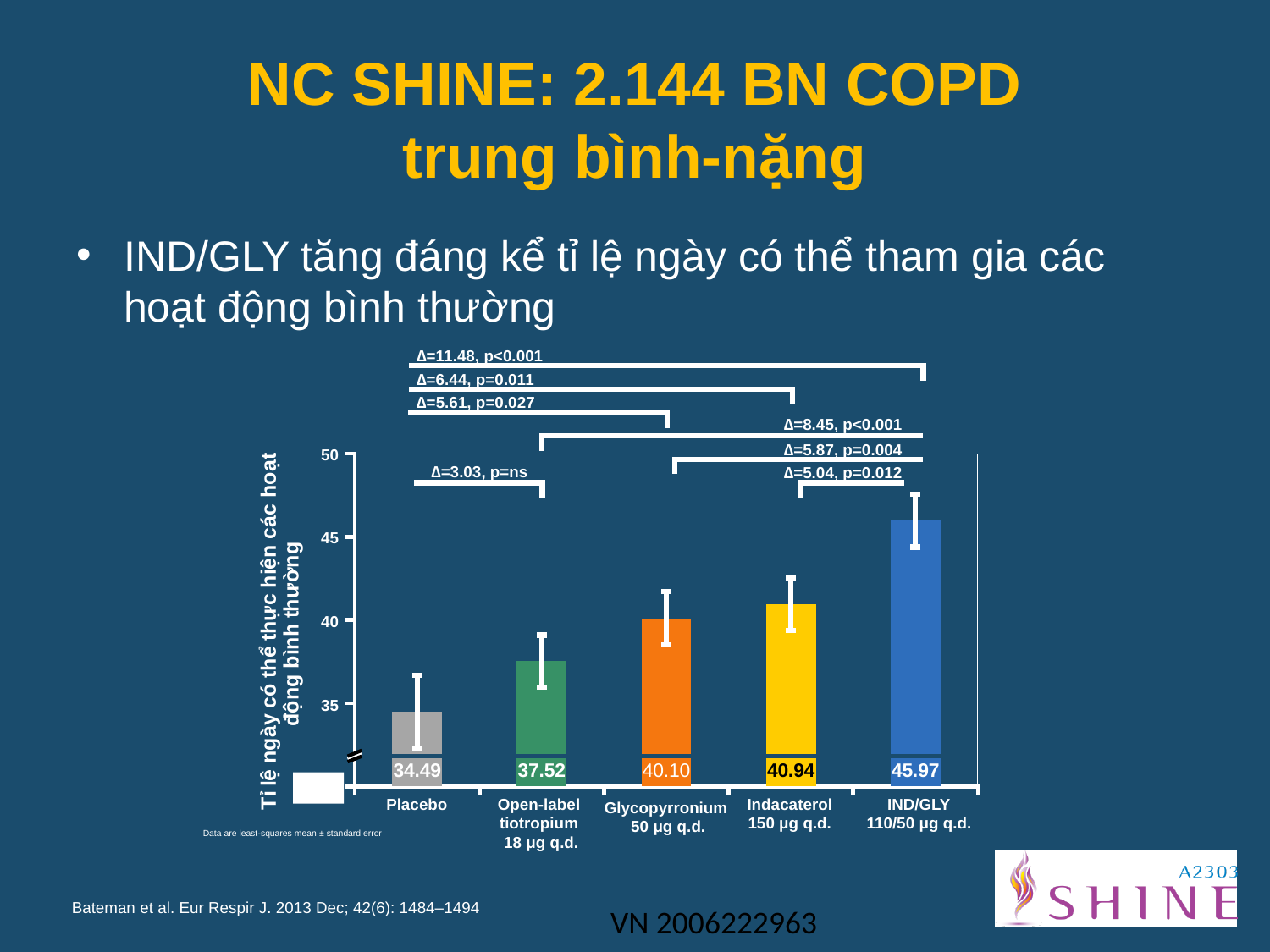
Which category has the highest value? IND/GLY 110/50 µg q.d. What is the value for Open-label tiotropium 18 µg q.d.? 37.52 Which category has the lowest value? Placebo What is the difference between the values for IND/GLY 110/50 µg q.d. and Placebo? 11.48 How many categories are shown in the chart? 5 What is the value for Glycopyrronium 50 µg q.d.? 40.10 What is the value for Placebo? 34.49 Is the value for Indacaterol 150 µg q.d. greater or less than 45? less What is the value for IND/GLY 110/50 µg q.d.? 45.97 Which is larger, the value for Indacaterol 150 µg q.d. or the value for Glycopyrronium 50 µg q.d.? Indacaterol 150 µg q.d. What is the difference between the values for IND/GLY 110/50 µg q.d. and Open-label tiotropium 18 µg q.d.? 8.45 What kind of chart is shown on the slide? bar chart